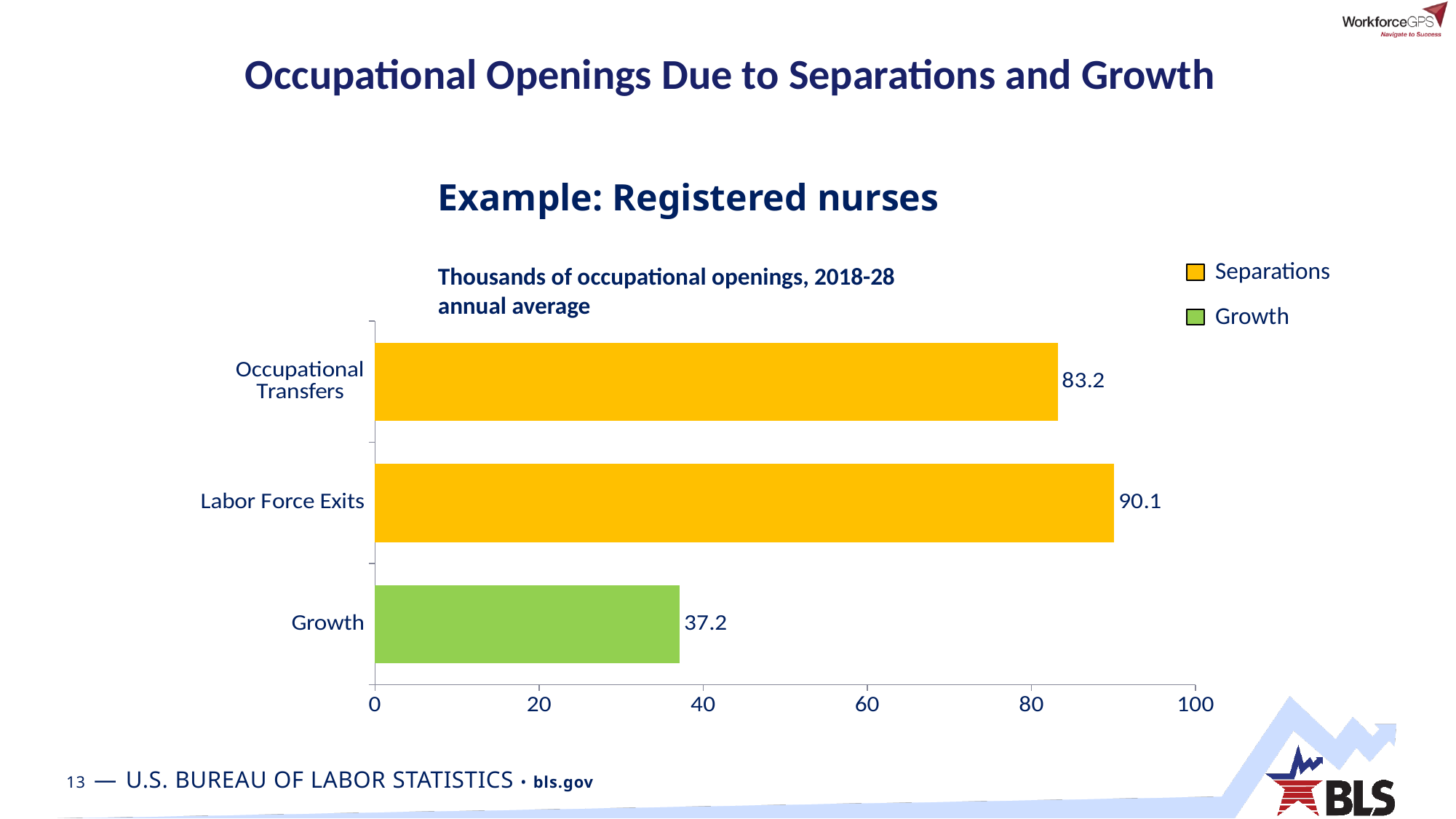
What is the difference between the values for Occupational Transfers and Growth? 46.0 Which category has the highest value? Labor Force Exits Which category has the lowest value? Growth Is the value for Growth greater or less than 40? less What is the value for Occupational Transfers? 83.2 What kind of chart is shown on the slide? bar chart How many series does the legend list? 2 How many categories are shown on the chart? 3 What is the difference between the values for Labor Force Exits and Occupational Transfers? 6.9 What is the value for Growth? 37.2 What is the value for Labor Force Exits? 90.1 Which is larger, the value for Growth or the value for Occupational Transfers? Occupational Transfers